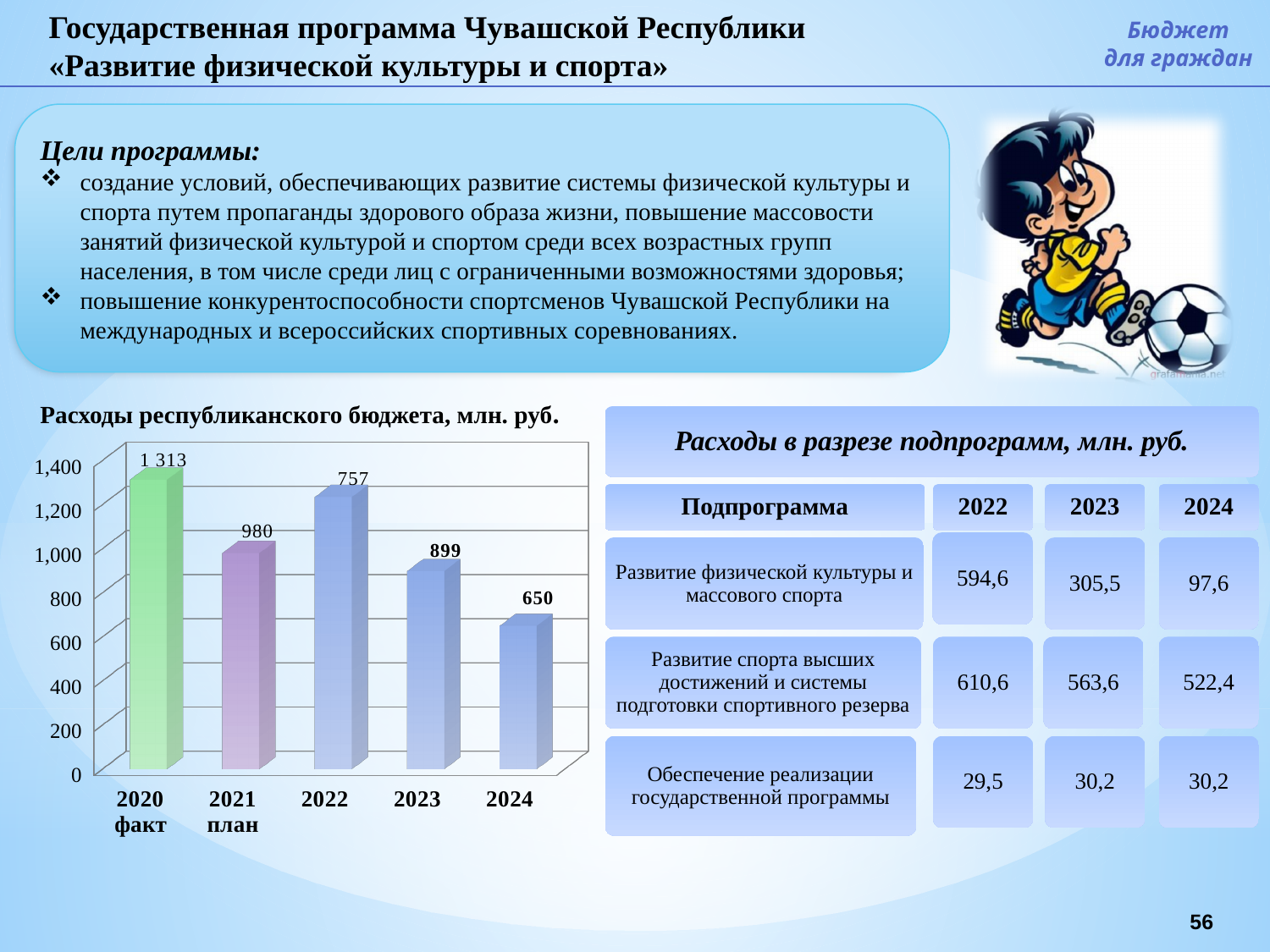
Which year has the highest value in the chart 'Расходы республиканского бюджета, млн. руб.'? 2020 факт In the chart 'Расходы республиканского бюджета, млн. руб.', which is larger: the value for 2021 план or the value for 2023? 2021 план What is the value for 2024 in the chart 'Расходы республиканского бюджета, млн. руб.'? 650 How many bars are shown in the chart 'Расходы республиканского бюджета, млн. руб.'? 5 What is the value for 2020 факт in the chart 'Расходы республиканского бюджета, млн. руб.'? 1 313 What type of chart is 'Расходы республиканского бюджета, млн. руб.'? bar chart In the chart 'Расходы республиканского бюджета, млн. руб.', what is the difference between the values for 2023 and 2024? 249 What is the value for 2023 in the chart 'Расходы республиканского бюджета, млн. руб.'? 899 What is the title of the chart on the left side of the slide? Расходы республиканского бюджета, млн. руб. In the chart 'Расходы республиканского бюджета, млн. руб.', what is the difference between the values for 2021 план and 2023? 81 What is the value for 2021 план in the chart 'Расходы республиканского бюджета, млн. руб.'? 980 Which year has the lowest value in the chart 'Расходы республиканского бюджета, млн. руб.'? 2024